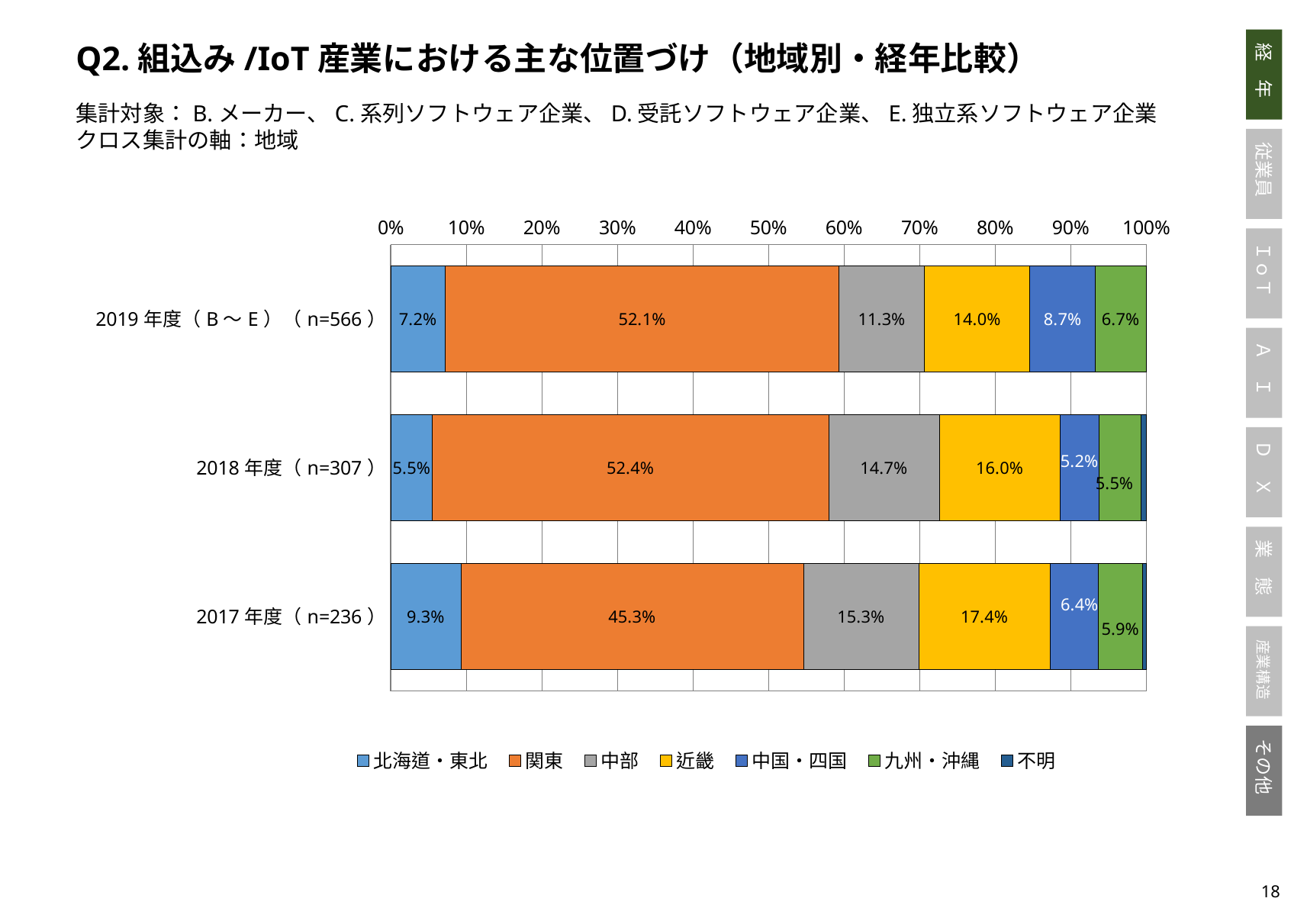
Which year has the lowest share for 中部? 2019年度 What kind of chart is shown on the slide? Stacked horizontal bar chart Which is larger, the 中国・四国 share in 2019年度 or in 2018年度? 2019年度 What is the difference between the 近畿 share in 2017年度 and in 2019年度? 3.4 percentage points How many bars (years) are shown in the chart? 3 What is the value for 近畿 in the 2017年度 bar? 17.4% Which year has the highest share for 北海道・東北? 2017年度 How many series does the legend list? 7 What is the value for 九州・沖縄 in the 2019年度 bar? 6.7% What is the value for 中部 in the 2018年度 bar? 14.7% What percentage does 関東 account for in the 2019年度 bar? 52.1% Does the share for 中部 rise or fall from 2017年度 to 2019年度? Fall